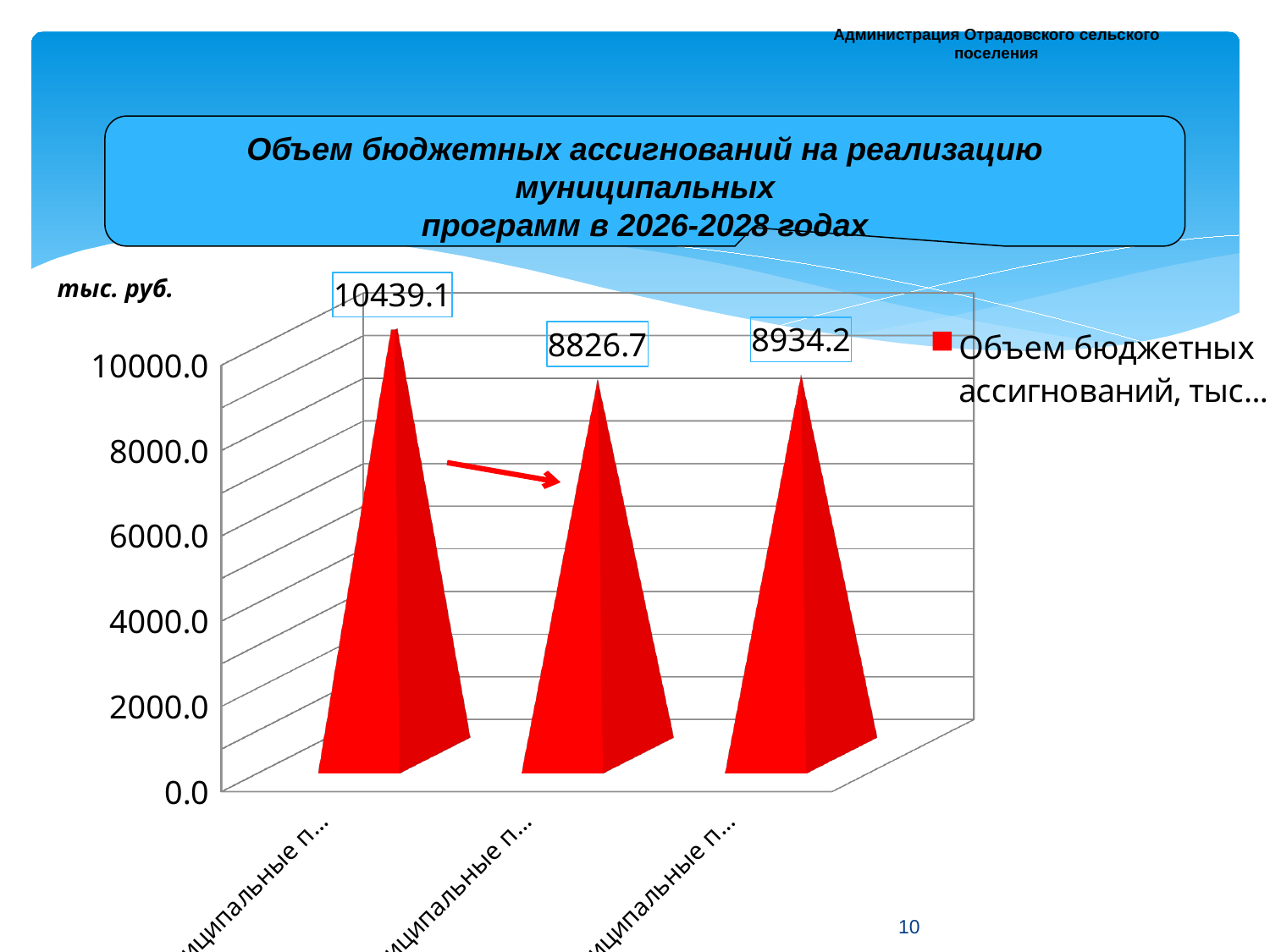
Which is larger: the value of the middle bar or the value of the rightmost bar? the rightmost bar What is the value shown on the leftmost bar of the chart? 10439.1 What is the value shown on the rightmost bar of the chart? 8934.2 What is the value shown on the middle bar of the chart? 8826.7 What is the difference between the rightmost bar's value and the middle bar's value? 107.5 Which bar has the lowest value: the left, middle or right one? middle Which bar has the highest value: the left, middle or right one? left How many bars are plotted in the chart? 3 Is the value of the leftmost bar greater or less than 10000.0? greater How many series does the chart legend list? 1 What is the difference between the leftmost bar's value and the middle bar's value? 1612.4 What kind of chart is shown on the slide? bar chart